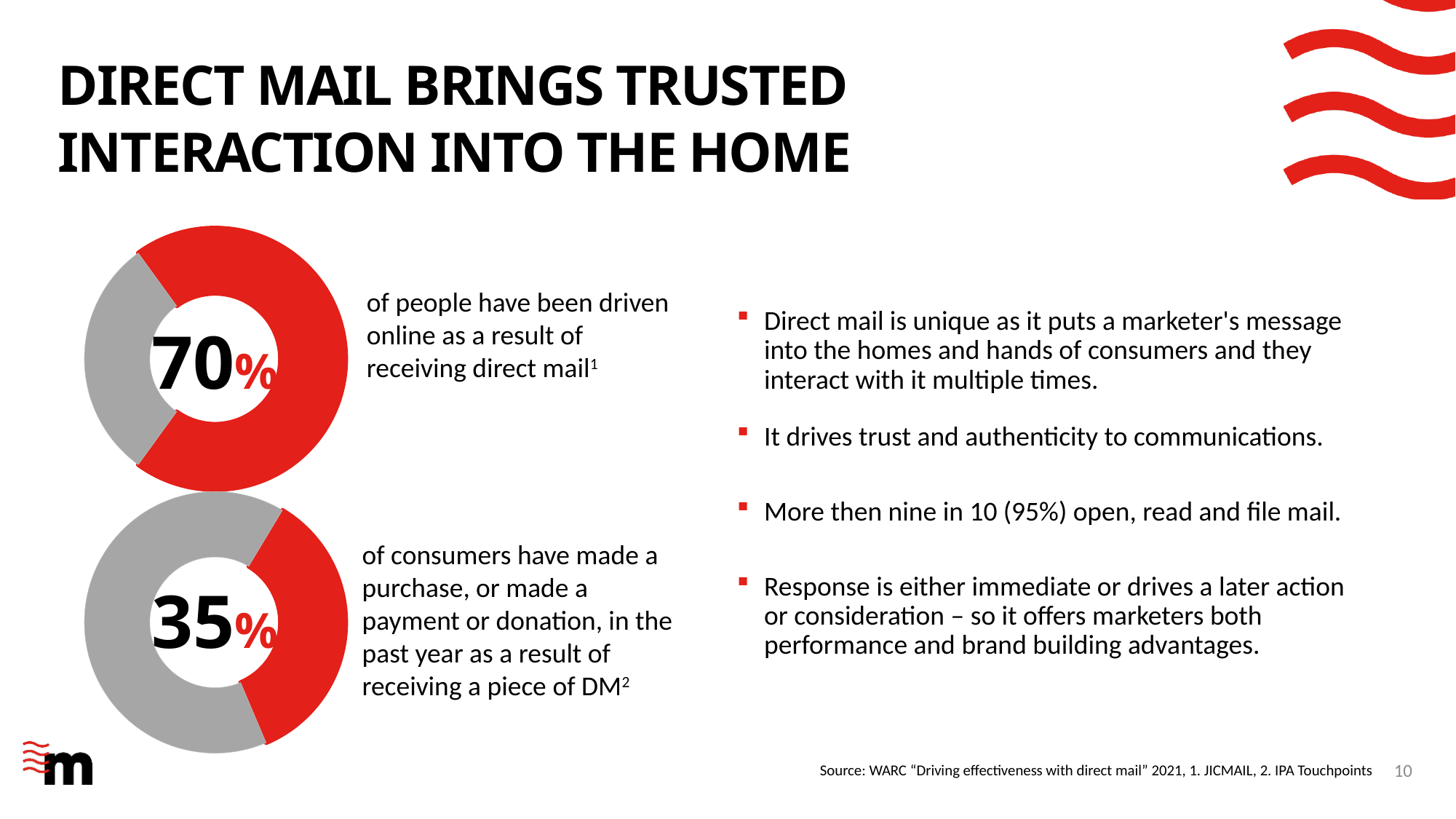
In the top donut chart, what percentage of people have been driven online as a result of receiving direct mail? 70% What is the difference between the percentage shown in the top donut chart and the percentage shown in the bottom donut chart? 35 percentage points What kind of chart is the top chart on the left of the slide? Donut (pie) chart In the bottom donut chart, is the highlighted red share greater or less than 50%? less What colour is used for the highlighted (labelled) segment in both donut charts? Red In the bottom donut chart, what percentage of consumers have made a purchase, payment or donation in the past year as a result of receiving a piece of DM? 35% How many segments does each donut chart on the slide have? 2 What kind of chart is the bottom chart on the left of the slide? Donut (pie) chart In the top donut chart, is the highlighted red share greater or less than 50%? greater In the top donut chart, what share of the donut is the grey segment? 30% How many donut charts are shown on the slide? 2 Which donut chart shows the larger highlighted share, the top one (driven online) or the bottom one (made a purchase)? The top one (70%)